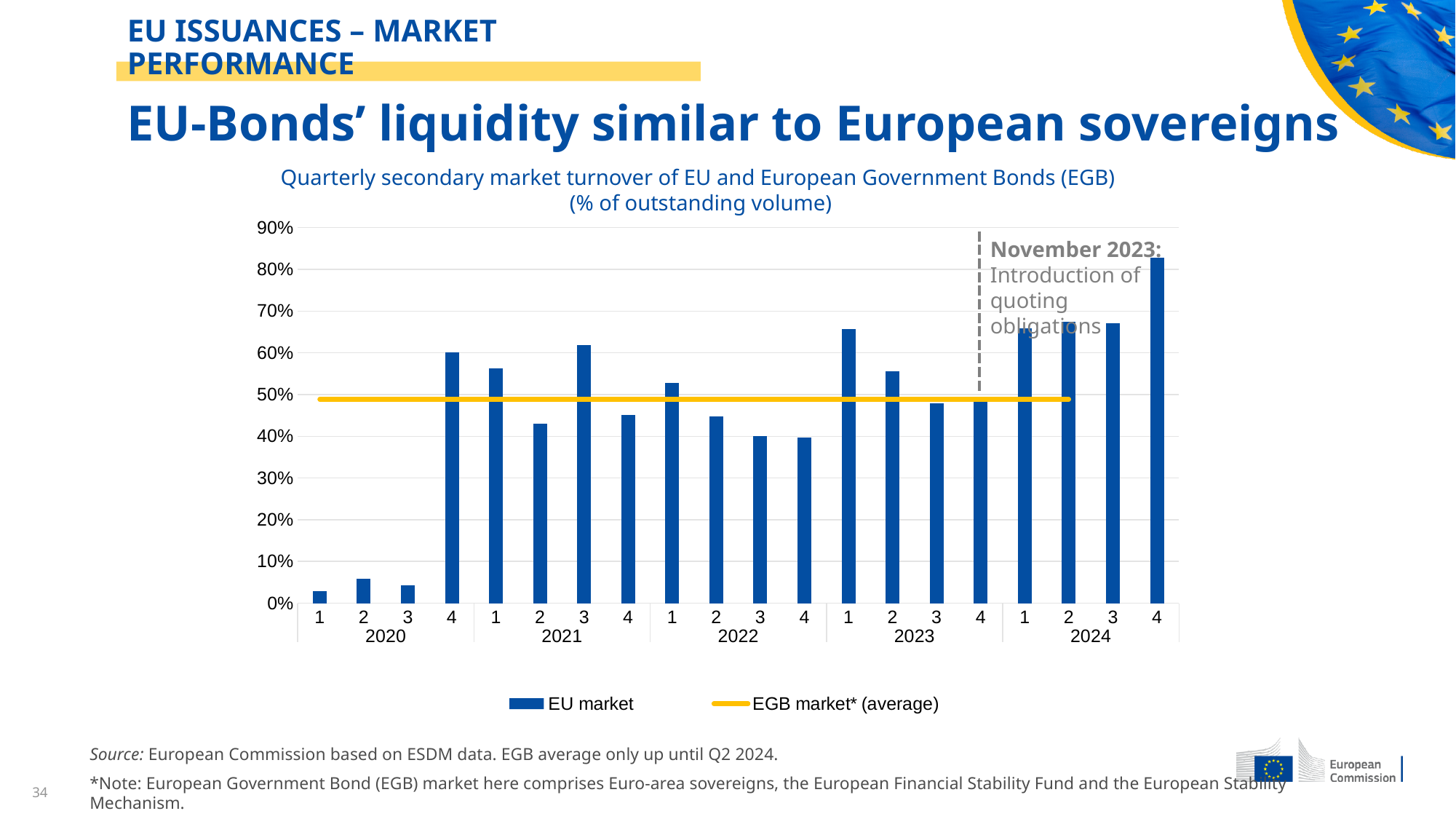
Is the EU market value for Q3 2022 greater or less than 50%? less How many series does the legend list? 2 Which quarter has the highest EU market turnover? Q4 2024 What kind of chart is shown on the slide? Bar chart (with a line for the EGB average) Which quarter has the lowest EU market turnover? Q1 2020 Is the EU market value for Q4 2020 greater or less than 50%? greater How many quarterly bars are plotted for the EU market? 20 What colour is the EGB market* (average) line in the chart? Yellow Is the EU market value for Q4 2024 greater or less than 80%? greater Which is larger, the EU market value for Q3 2021 or for Q4 2021? Q3 2021 Which is larger, the EU market value for Q1 2023 or for Q2 2023? Q1 2023 Do the EU market values rise or fall across the four quarters of 2024? rise